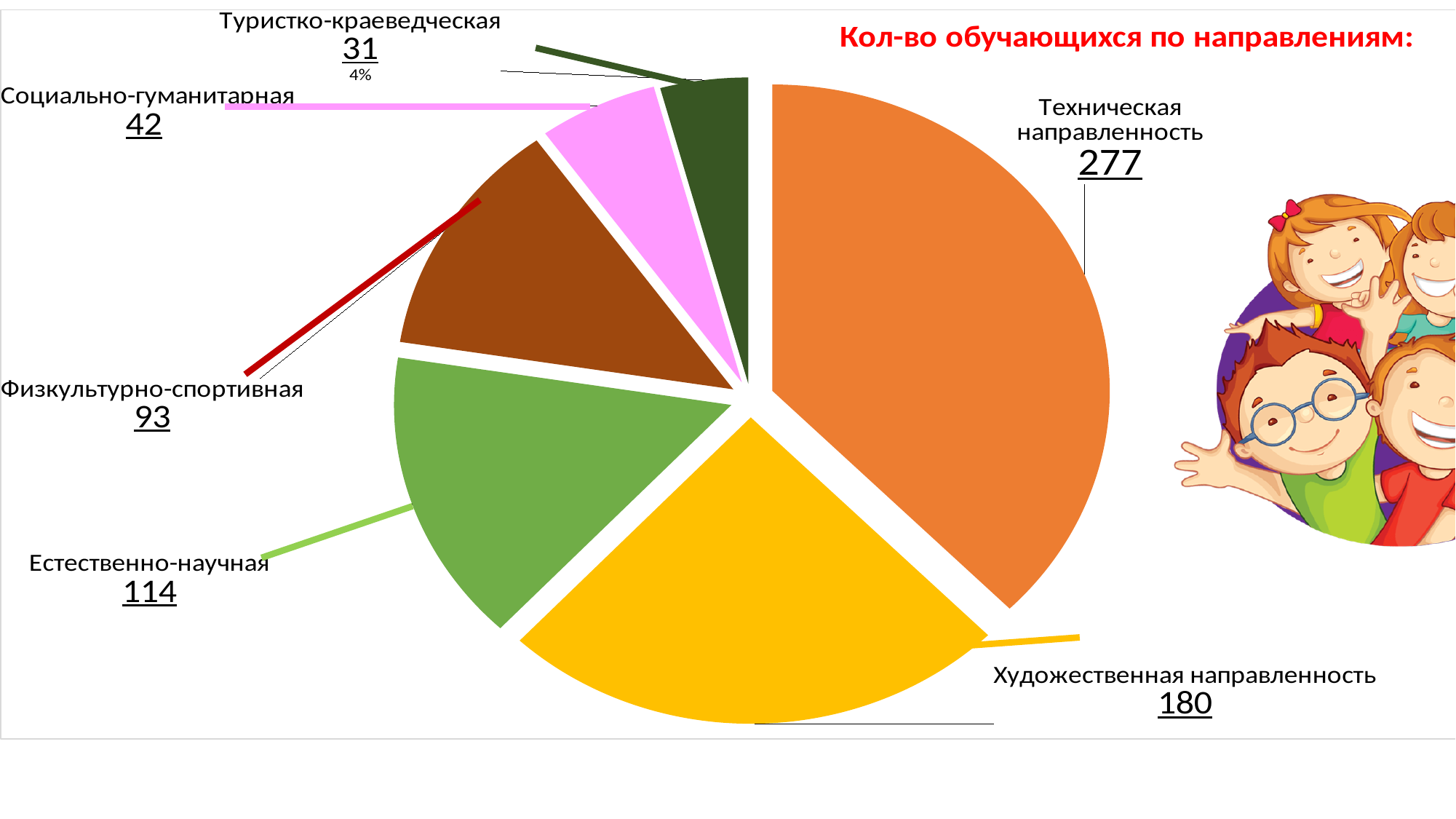
What is the value for Естественно-научная? 114 What is the value for Социально-гуманитарная? 42 What kind of chart is shown on the slide? pie chart How many slices does the pie chart have? 6 What is the difference between the values for Техническая направленность and Художественная направленность? 97 What is the value for Физкультурно-спортивная? 93 What is the value for Техническая направленность? 277 What is the value for Художественная направленность? 180 Which category has the largest slice? Техническая направленность Which category has the smallest slice? Туристко-краеведческая What share of the pie does Туристко-краеведческая represent? 4% What is the title of the chart? Кол-во обучающихся по направлениям: